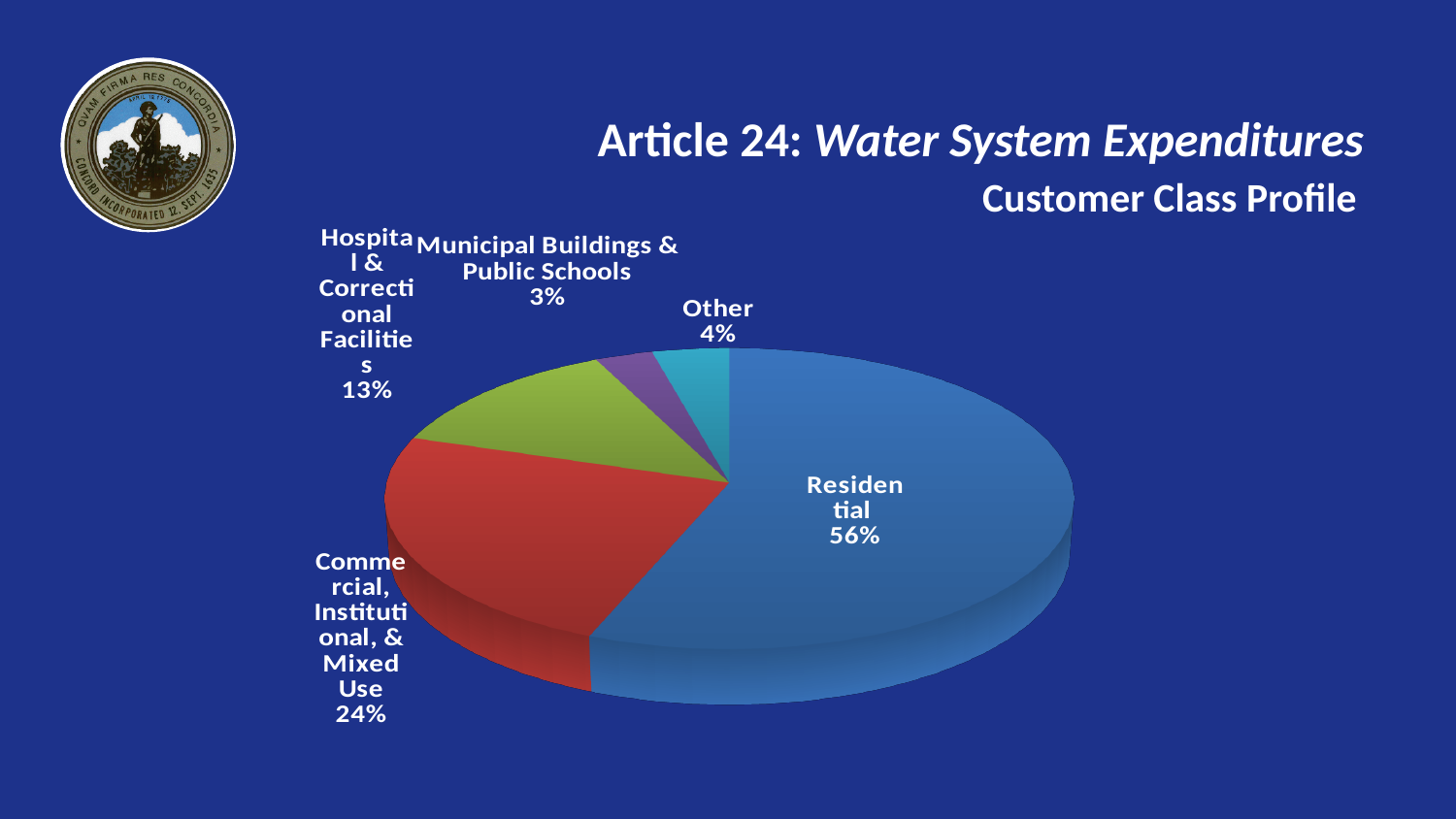
What percentage is shown for Hospital & Correctional Facilities? 13% Which is larger, the share for Other or the share for Municipal Buildings & Public Schools? Other What kind of chart is shown on the slide? Pie chart Which customer class has the largest share of the pie? Residential What share of the pie does Residential account for? 56% How many slices does the pie chart have? 5 What is the subtitle of the chart shown on the slide? Customer Class Profile Which customer class has the smallest share of the pie? Municipal Buildings & Public Schools What is the difference in percentage points between Residential and Commercial, Institutional, & Mixed Use? 32 What percentage is shown for Municipal Buildings & Public Schools? 3% What percentage is shown for Other? 4% What percentage is shown for Commercial, Institutional, & Mixed Use? 24%